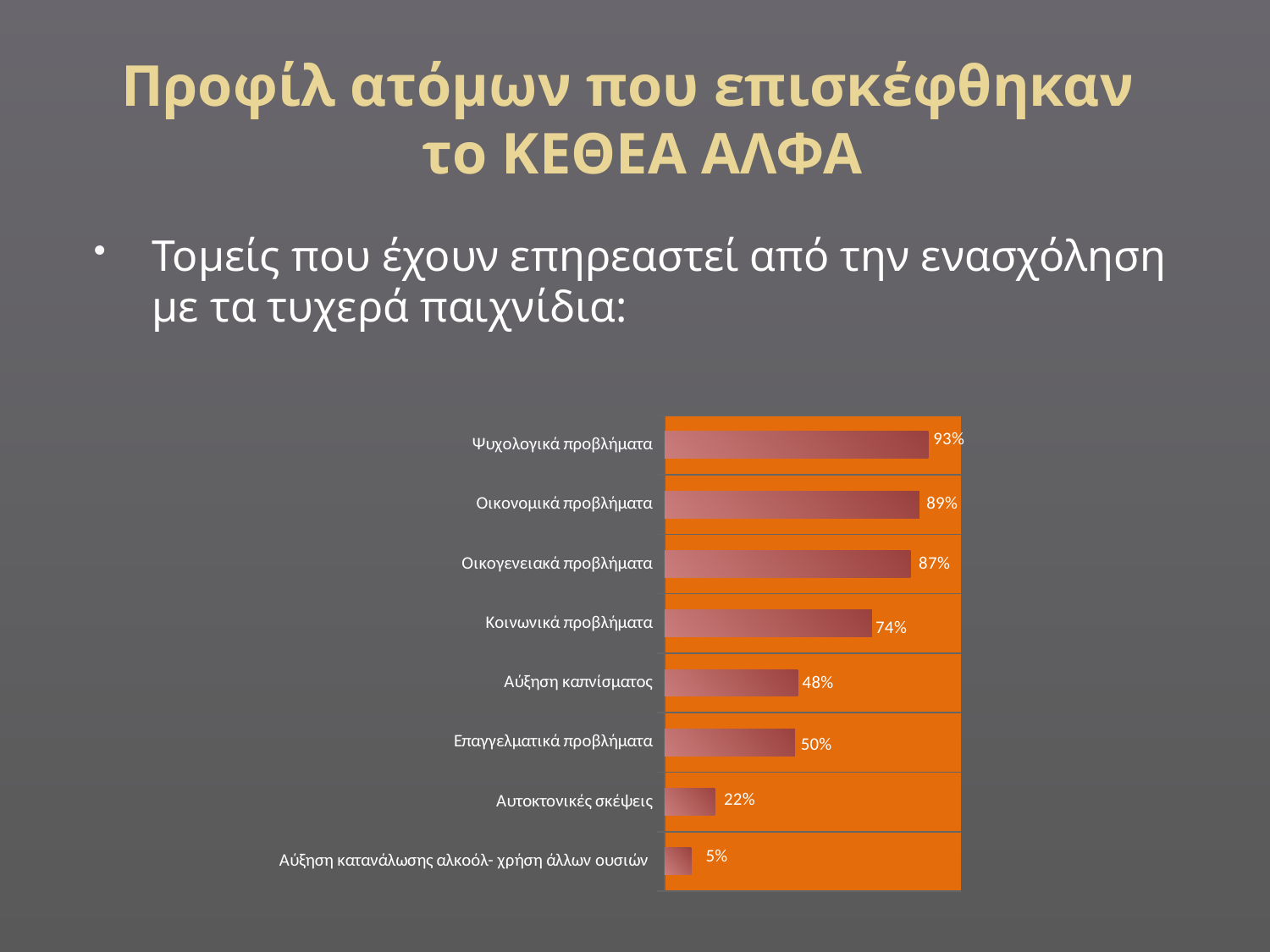
What value is shown for Οικογενειακά προβλήματα? 87% What is the difference between the values for Οικονομικά προβλήματα and Κοινωνικά προβλήματα? 15% How many categories are shown in the chart? 8 What is the difference between the values for Επαγγελματικά προβλήματα and Αυτοκτονικές σκέψεις? 28% Which is larger, the value for Οικογενειακά προβλήματα or the value for Κοινωνικά προβλήματα? Οικογενειακά προβλήματα What value is shown for Ψυχολογικά προβλήματα? 93% Which category has the lowest value? Αύξηση κατανάλωσης αλκοόλ- χρήση άλλων ουσιών Which category has the highest value? Ψυχολογικά προβλήματα What value is shown for Αυτοκτονικές σκέψεις? 22% What value is shown for Αύξηση καπνίσματος? 48% What kind of chart is shown on the slide? Bar chart